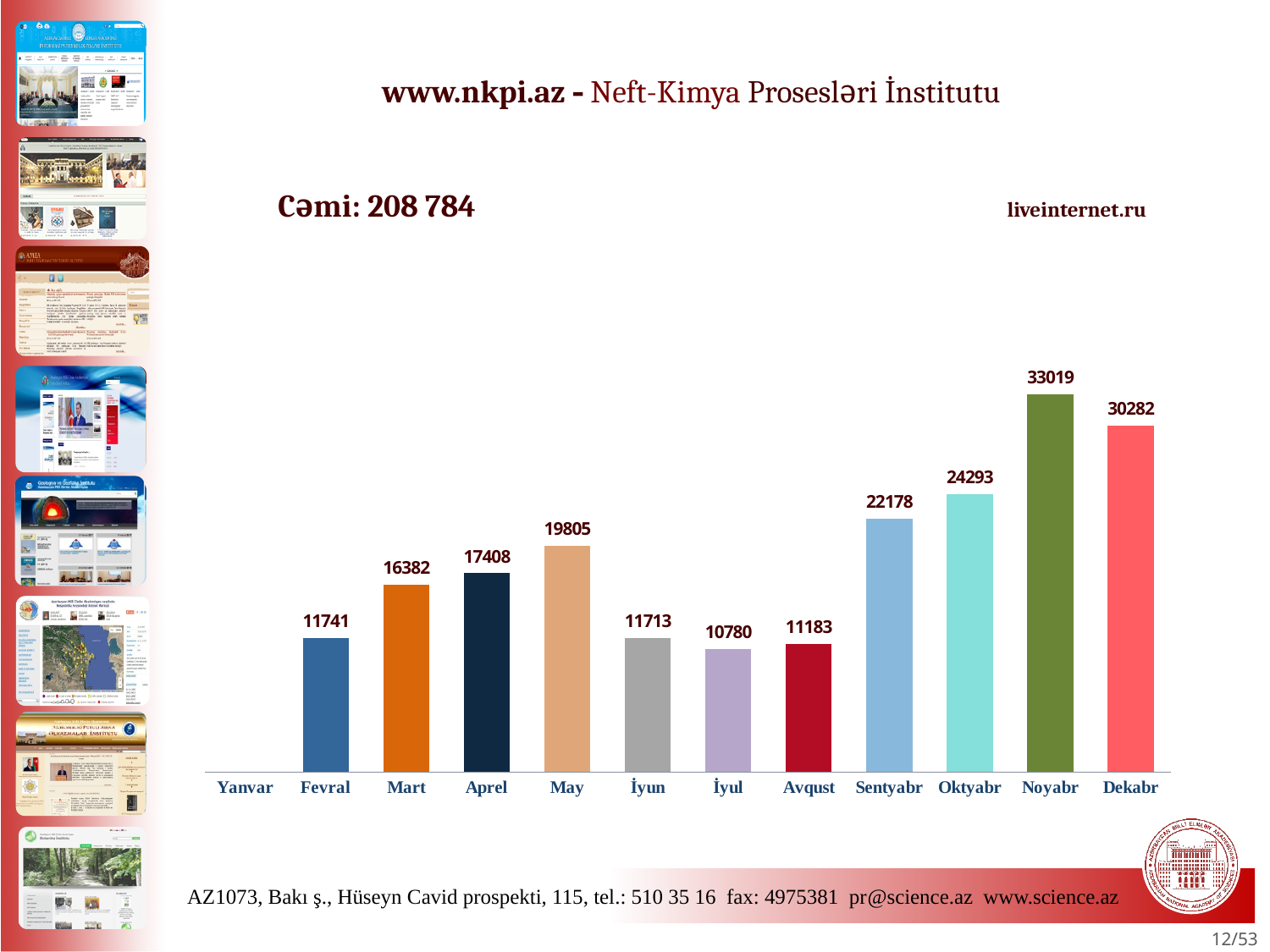
What is the difference between the values for Oktyabr and Sentyabr? 2115 What is the value for Fevral? 11741 Which is larger, the value for Mart or the value for Avqust? Mart Which is larger, the value for May or the value for Aprel? May What is the value for Noyabr? 33019 What is the difference between the values for Noyabr and Dekabr? 2737 Which month with a bar has the lowest value? İyul What kind of chart is shown on the slide? Bar chart What is the value for Sentyabr? 22178 How many month categories are shown on the x axis? 12 What total (Cəmi) is stated above the chart? 208 784 Which month has the highest value? Noyabr